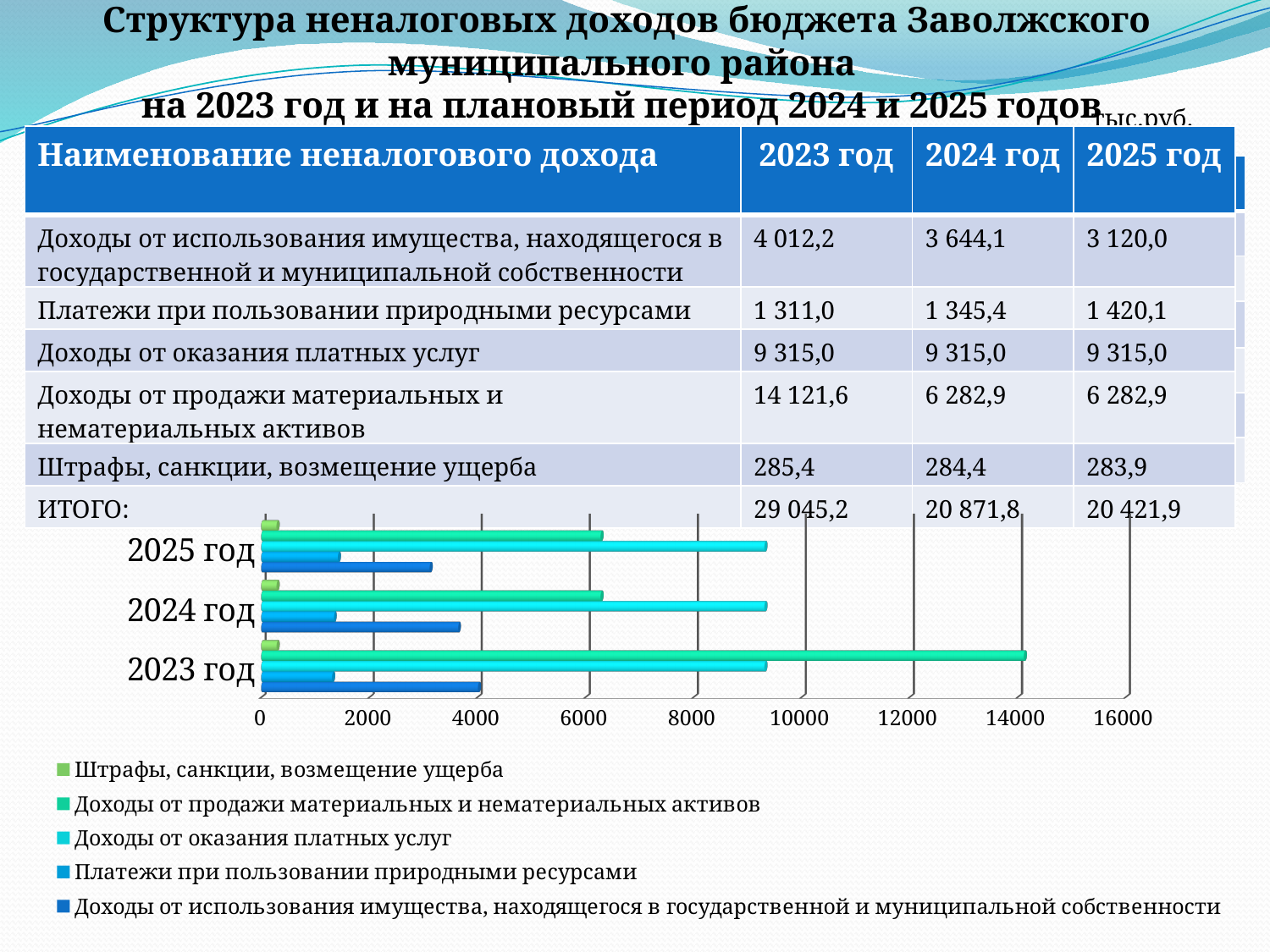
What kind of chart is shown on the slide? bar chart Do the bars for «Доходы от использования имущества, находящегося в государственной и муниципальной собственности» rise or fall from 2023 год to 2025 год? fall What is the highest tick value shown on the chart's horizontal axis? 16000 What is the difference between «Доходы от продажи материальных и нематериальных активов» in 2023 год and in 2024 год? 7 838,7 How many year categories are plotted on the chart's vertical axis? 3 Is the bar for «Доходы от продажи материальных и нематериальных активов» in 2023 год greater or less than 14000? greater Which is larger: the bar for «Доходы от использования имущества, находящегося в государственной и муниципальной собственности» in 2023 год or in 2025 год? 2023 год Is the bar for «Доходы от оказания платных услуг» in 2024 год greater or less than 8000? greater What is the value of «Доходы от продажи материальных и нематериальных активов» for 2023 год? 14 121,6 In which year is the bar for «Доходы от продажи материальных и нематериальных активов» the longest? 2023 год How many series does the chart's legend list? 5 Which series has the shortest bars in every year on the chart? Штрафы, санкции, возмещение ущерба